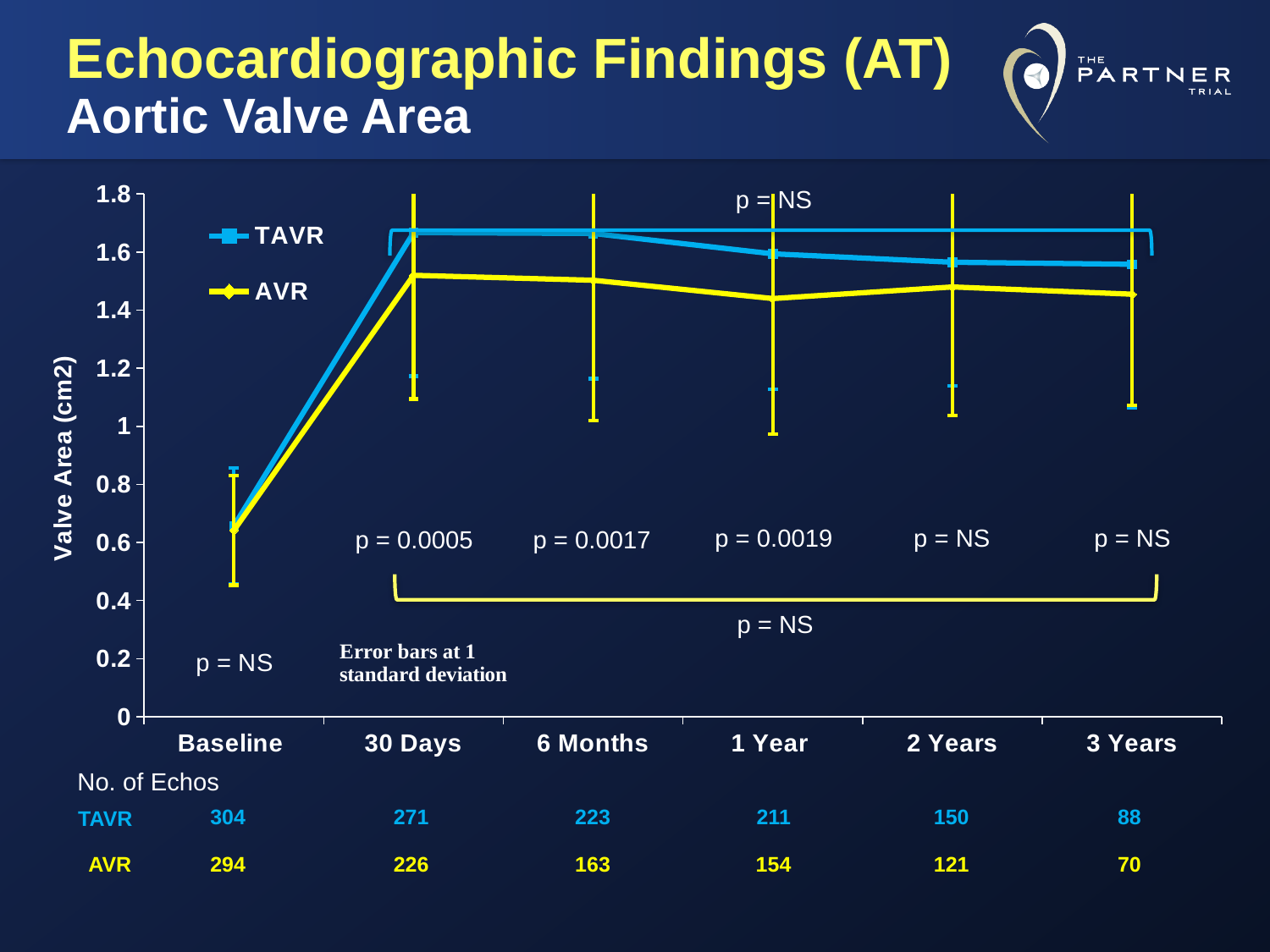
What is the number of echos for TAVR at 3 Years? 88 Is the AVR value at 1 Year greater or less than 1.6? less At 30 Days, which series has the higher valve area, TAVR or AVR? TAVR Do the valve area values rise or fall from Baseline to 30 Days? rise What kind of chart is shown on the slide? Line chart Is the AVR value at Baseline greater or less than 0.8? less At which time point is the TAVR valve area lowest? Baseline How many series does the legend list? 2 What is the difference between the number of echos for TAVR and AVR at 6 Months? 60 Is the TAVR value at 30 Days greater or less than 1.6? greater How many time points are plotted along the x axis? 6 What is the label of the y axis? Valve Area (cm2)